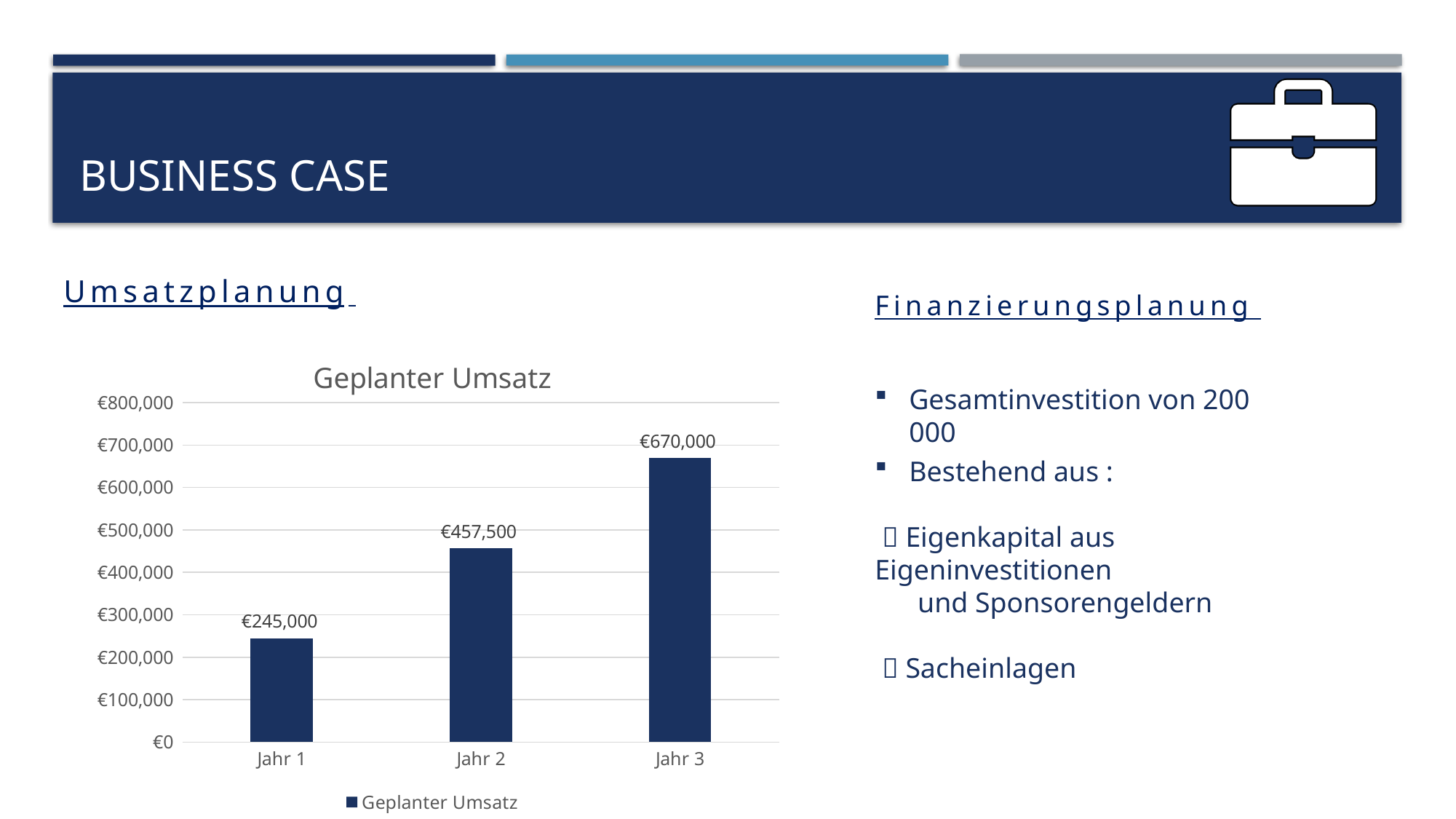
Which year has the highest Geplanter Umsatz? Jahr 3 Is the value for Jahr 2 greater or less than €400,000? greater What is the value for Jahr 3 in the Geplanter Umsatz chart? €670,000 Which is larger, the Geplanter Umsatz for Jahr 2 or Jahr 3? Jahr 3 What kind of chart is shown on the slide? Bar chart What is the difference between the Geplanter Umsatz for Jahr 3 and Jahr 1? €425,000 Do the values rise or fall from Jahr 1 to Jahr 3? Rise What is the value for Jahr 1 in the Geplanter Umsatz chart? €245,000 How many categories are shown on the x axis of the chart? 3 What is the difference between the Geplanter Umsatz for Jahr 2 and Jahr 1? €212,500 What is the value for Jahr 2 in the Geplanter Umsatz chart? €457,500 Which year has the lowest Geplanter Umsatz? Jahr 1